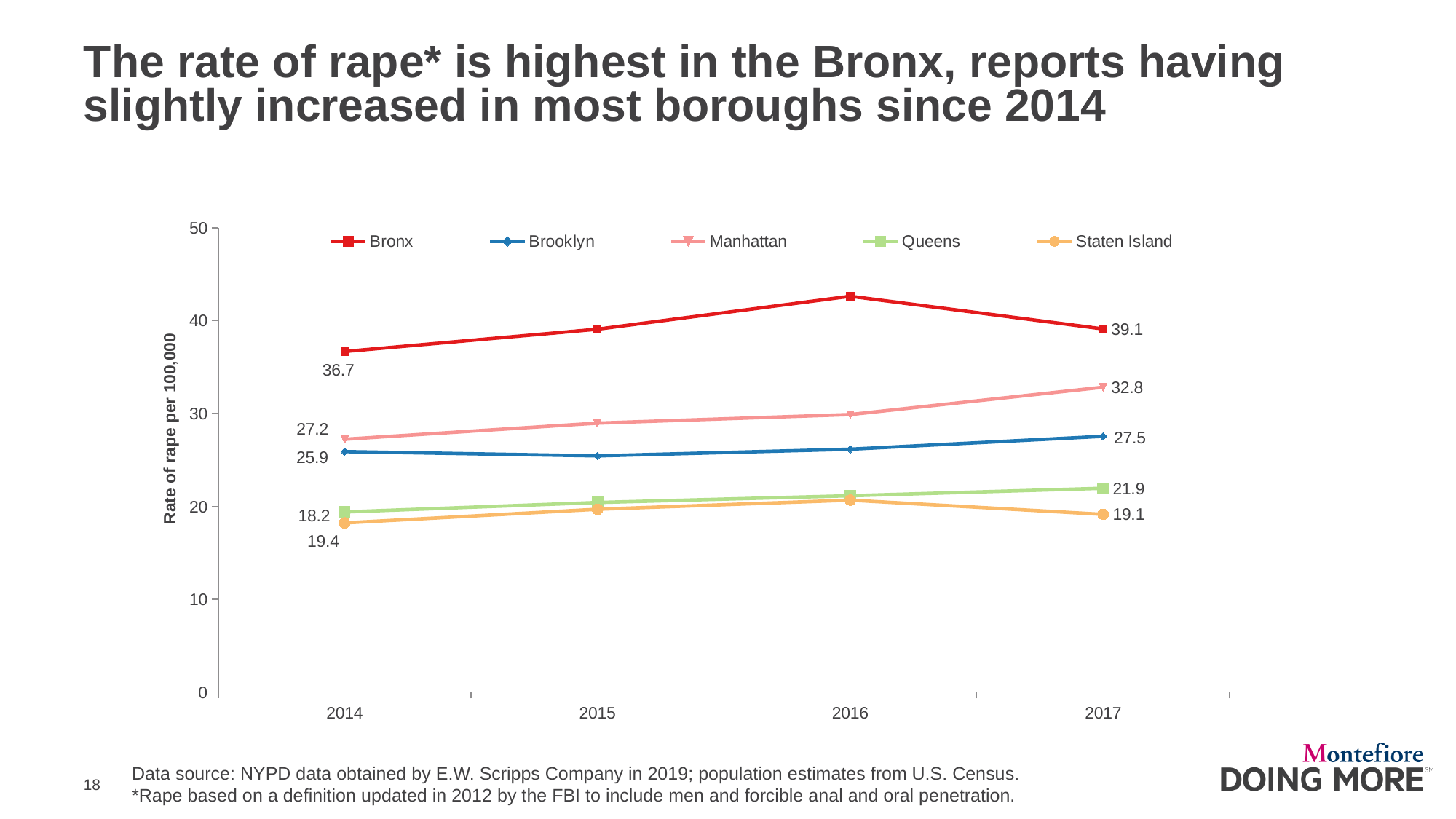
What is the difference between Manhattan's and Brooklyn's rate of rape in 2017? 5.3 By how much did the Bronx rate of rape change from 2014 (36.7) to 2017 (39.1)? 2.4 Is the Bronx rate of rape in 2016 greater or less than 40? greater Which borough has the highest rate of rape in 2017? Bronx In 2014, which borough had a higher rate of rape, Manhattan or Brooklyn? Manhattan Which borough has the lowest rate of rape in 2017? Staten Island What is the rate of rape per 100,000 in the Bronx in 2017? 39.1 What is the rate of rape per 100,000 in Manhattan in 2014? 27.2 How many years are shown on the x axis of the chart? 4 What type of chart is shown on the slide? Line chart How many boroughs are listed in the chart legend? 5 What is the rate of rape per 100,000 in Brooklyn in 2017? 27.5